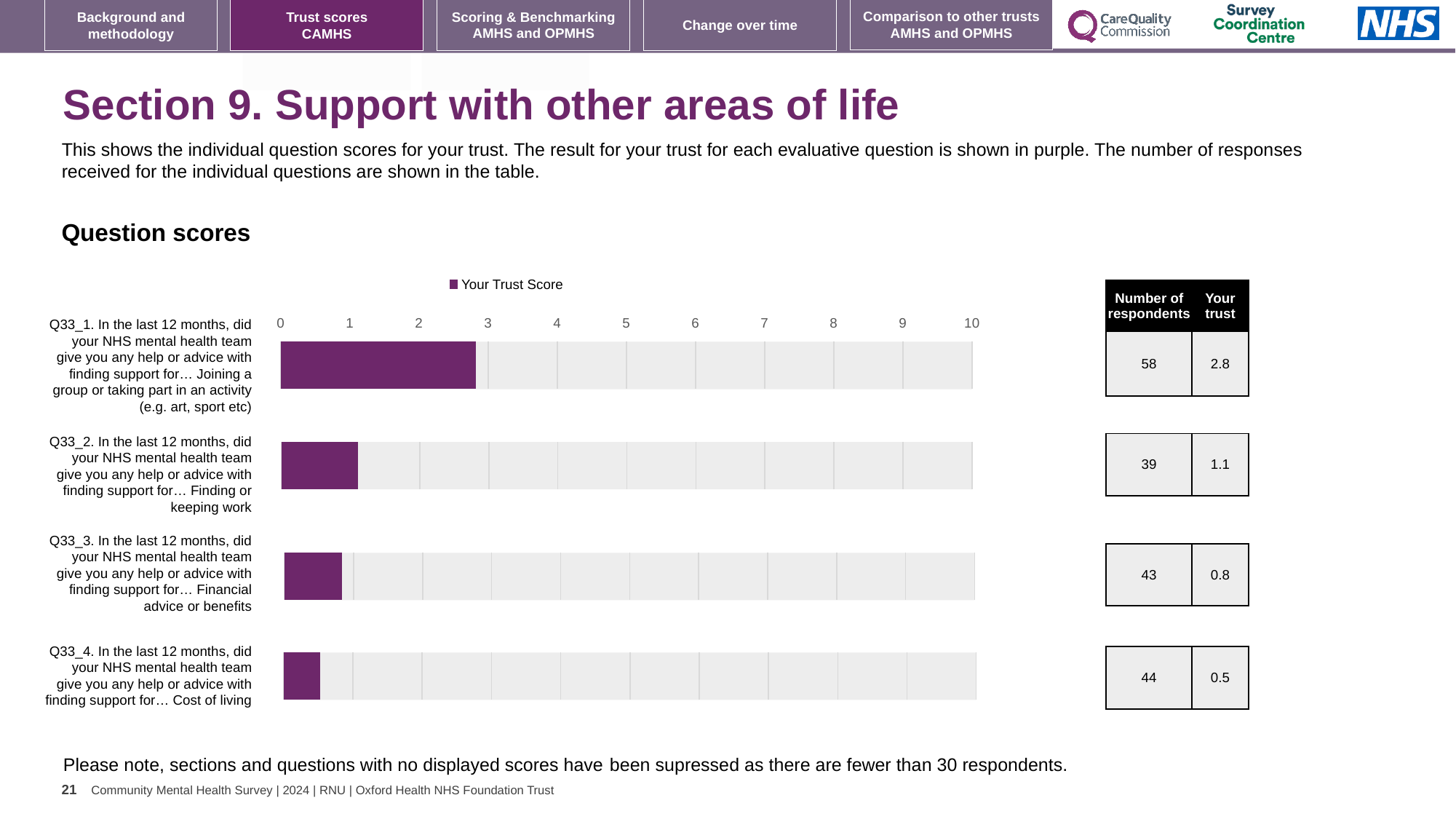
What type of chart is shown? Bar chart What is the difference between the trust scores for Q33_1 and Q33_4? 2.3 What is the trust score for Q33_2 (Finding or keeping work)? 1.1 What is the name of the series shown in the legend? Your Trust Score Is the trust score for Q33_1 greater or less than 2? greater How many series does the legend list? 1 Which has a higher trust score, Q33_2 (Finding or keeping work) or Q33_3 (Financial advice or benefits)? Q33_2 (Finding or keeping work) What is the trust score for Q33_4 (Cost of living)? 0.5 Which question has the highest trust score? Q33_1 (Joining a group or taking part in an activity) Which question has the lowest trust score? Q33_4 (Cost of living) How many questions are plotted in the chart? 4 What is the trust score for Q33_1 (Joining a group or taking part in an activity)? 2.8